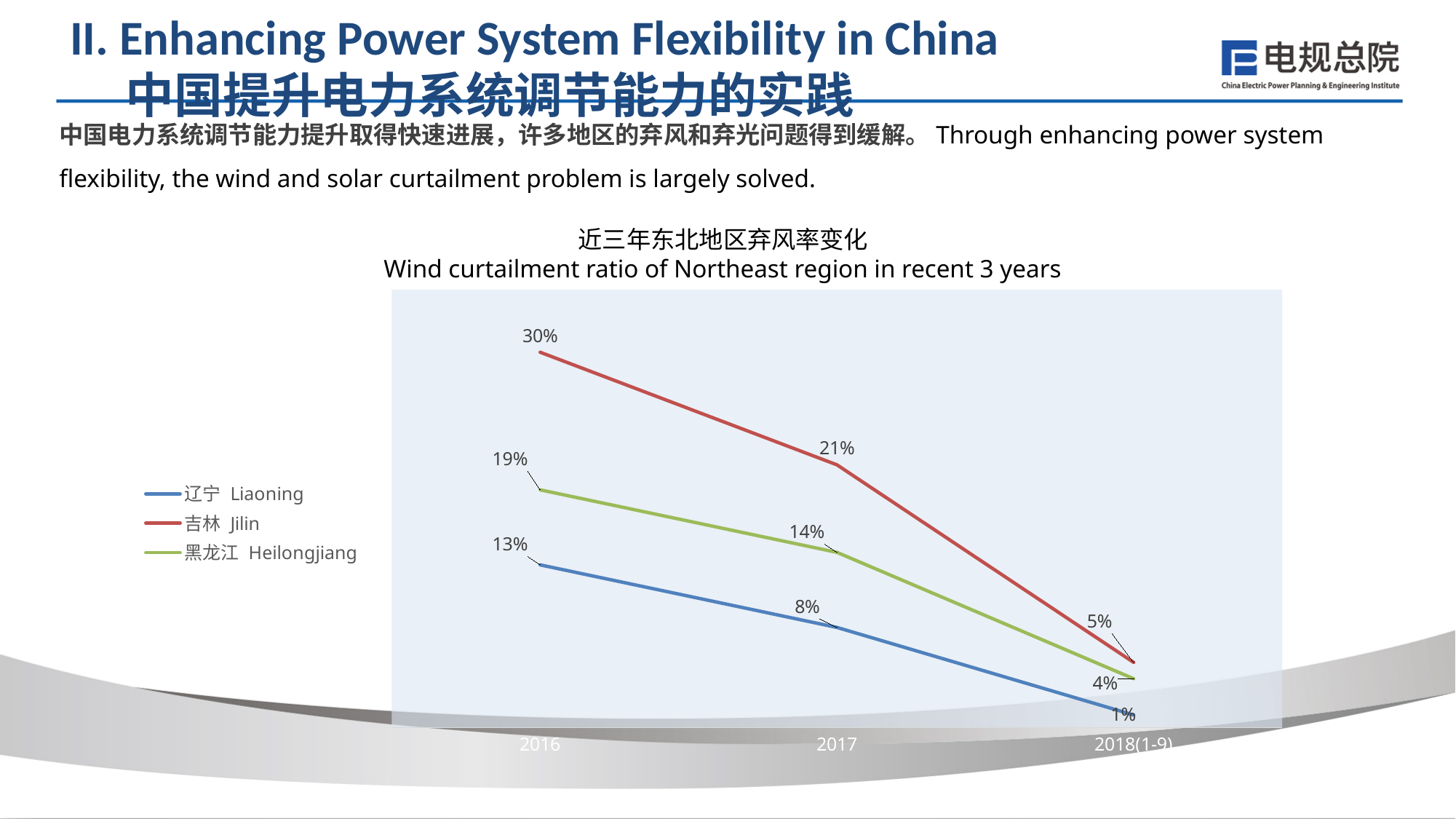
What was the wind curtailment ratio for Heilongjiang in 2018(1-9)? 4% What kind of chart is shown on the slide? Line chart What was the wind curtailment ratio for Jilin in 2016? 30% Which province had the lowest wind curtailment ratio in 2018(1-9)? Liaoning Which was higher in 2018(1-9), the wind curtailment ratio of Jilin or Heilongjiang? Jilin How many time periods are shown on the x axis? 3 What is the difference between Heilongjiang's and Liaoning's wind curtailment ratios in 2017? 6 percentage points Which province had the highest wind curtailment ratio in 2016? Jilin How many series does the legend list? 3 Does the wind curtailment ratio for Liaoning rise or fall from 2016 to 2018(1-9)? Fall By how many percentage points did Jilin's wind curtailment ratio fall from 2016 to 2017? 9 percentage points What was the wind curtailment ratio for Liaoning in 2017? 8%